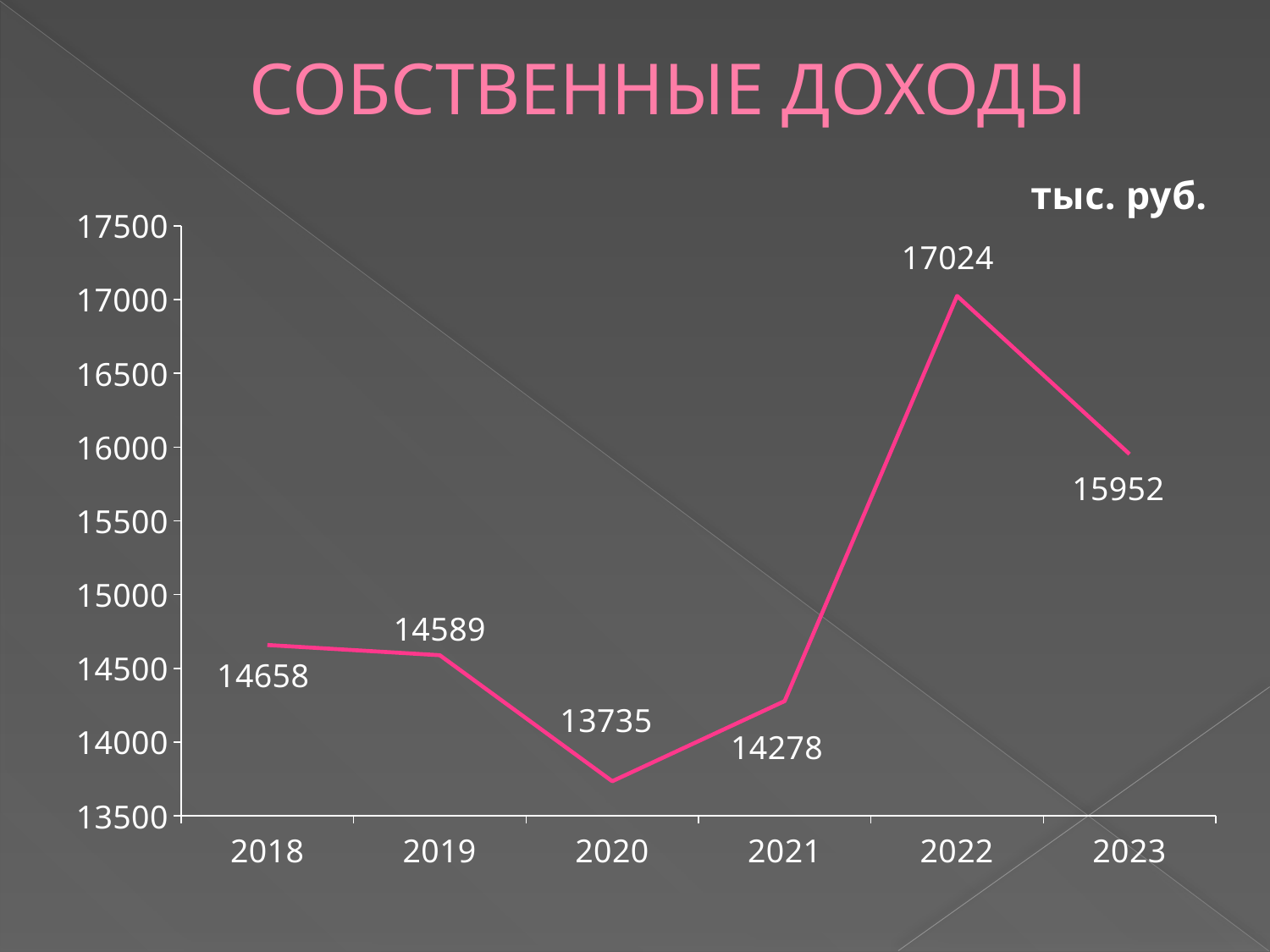
What is the difference between the values for 2022 and 2023? 1072 How many years are plotted on the chart? 6 What is the value for 2018? 14658 Which year has the lowest value? 2020 What is the difference between the values for 2019 and 2020? 854 What is the value for 2023? 15952 What is the value for 2020? 13735 What kind of chart is shown on the slide? line chart Which is larger, the value for 2018 or the value for 2021? 2018 What is the value for 2022? 17024 What is the title of the chart? СОБСТВЕННЫЕ ДОХОДЫ Which year has the highest value? 2022